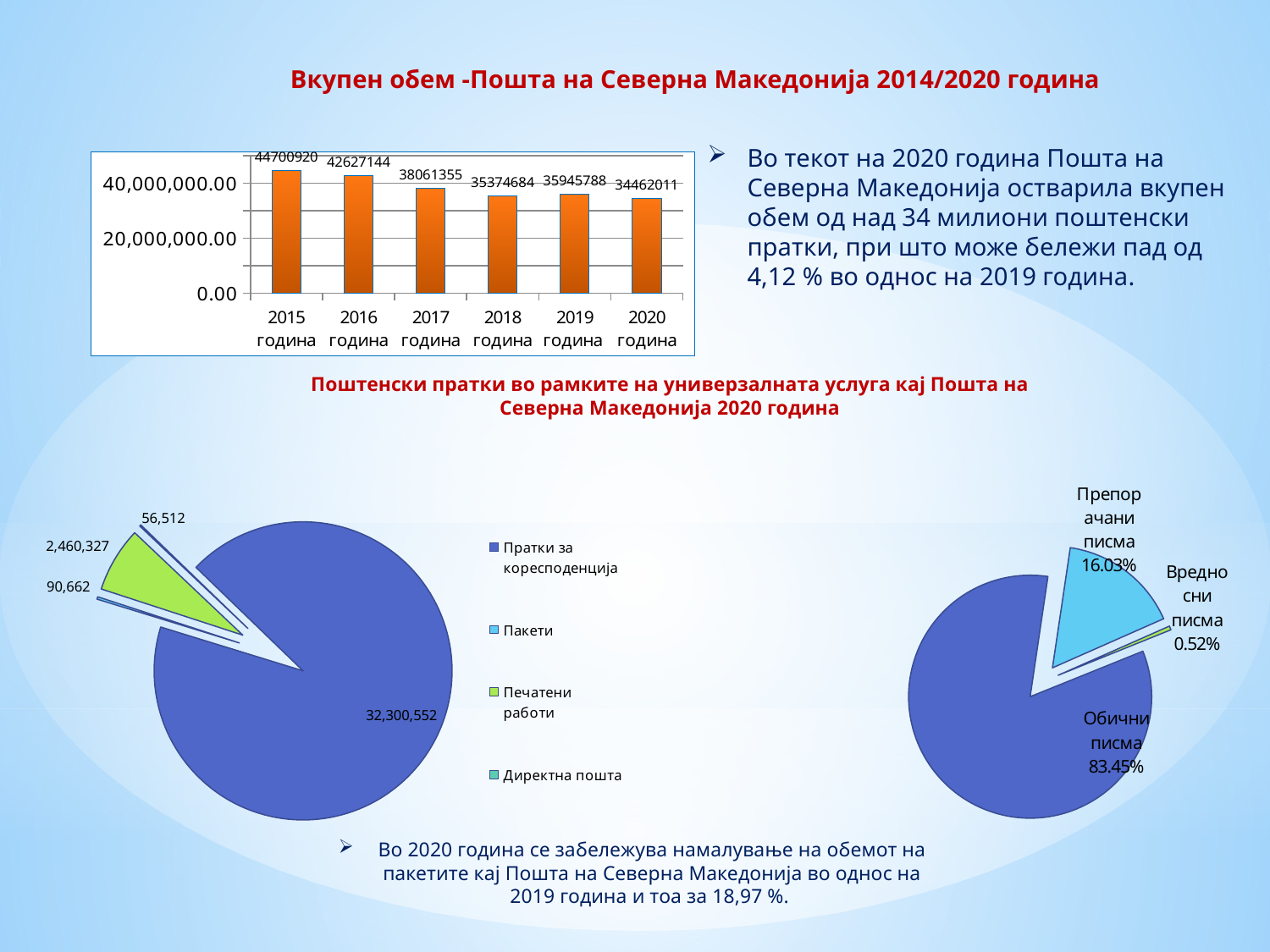
In the bar chart at the top left, which is larger, the value for 2018 година or 2019 година? 2019 година In the pie chart at the bottom right, which slice is the smallest? Вредносни писма In the bar chart at the top left, what is the difference between the values for 2019 година and 2020 година? 1483777 In the bar chart at the top left, which year has the highest value? 2015 година In the bar chart at the top left, what is the value for 2020 година? 34462011 In the pie chart at the bottom right, what share does Обични писма have? 83.45% In the pie chart at the bottom left, how many categories does the legend list? 4 In the bar chart at the top left, which year has the lowest value? 2020 година In the pie chart at the bottom left, what is the value for Пратки за кореспонденција? 32,300,552 In the bar chart at the top left, what is the value for 2015 година? 44700920 In the bar chart at the top left, how many years are shown? 6 What kind of chart is the chart at the top left of the slide? bar chart